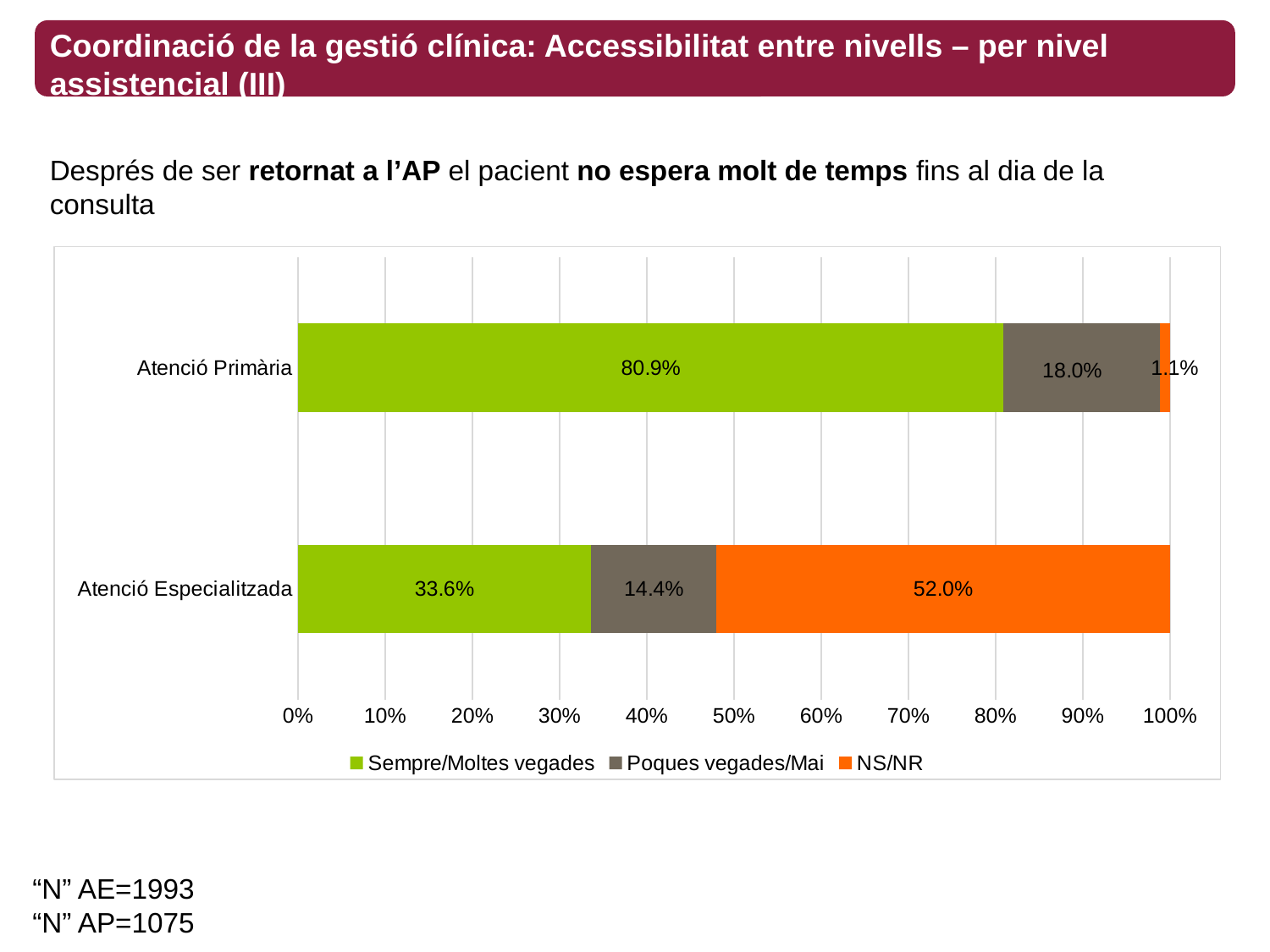
What is the value of Sempre/Moltes vegades for Atenció Primària? 80.9% What is the value of NS/NR for Atenció Primària? 1.1% What is the value of Poques vegades/Mai for Atenció Primària? 18.0% What is the value of NS/NR for Atenció Especialitzada? 52.0% Which category has the higher value for Sempre/Moltes vegades? Atenció Primària How many series does the legend list? 3 How many categories are shown on the chart? 2 What is the value of Sempre/Moltes vegades for Atenció Especialitzada? 33.6% Is the Poques vegades/Mai value larger for Atenció Primària or Atenció Especialitzada? Atenció Primària Which category has the lower value for NS/NR? Atenció Primària What kind of chart is shown on the slide? Stacked bar chart What is the difference between the Sempre/Moltes vegades values for Atenció Primària and Atenció Especialitzada? 47.3%